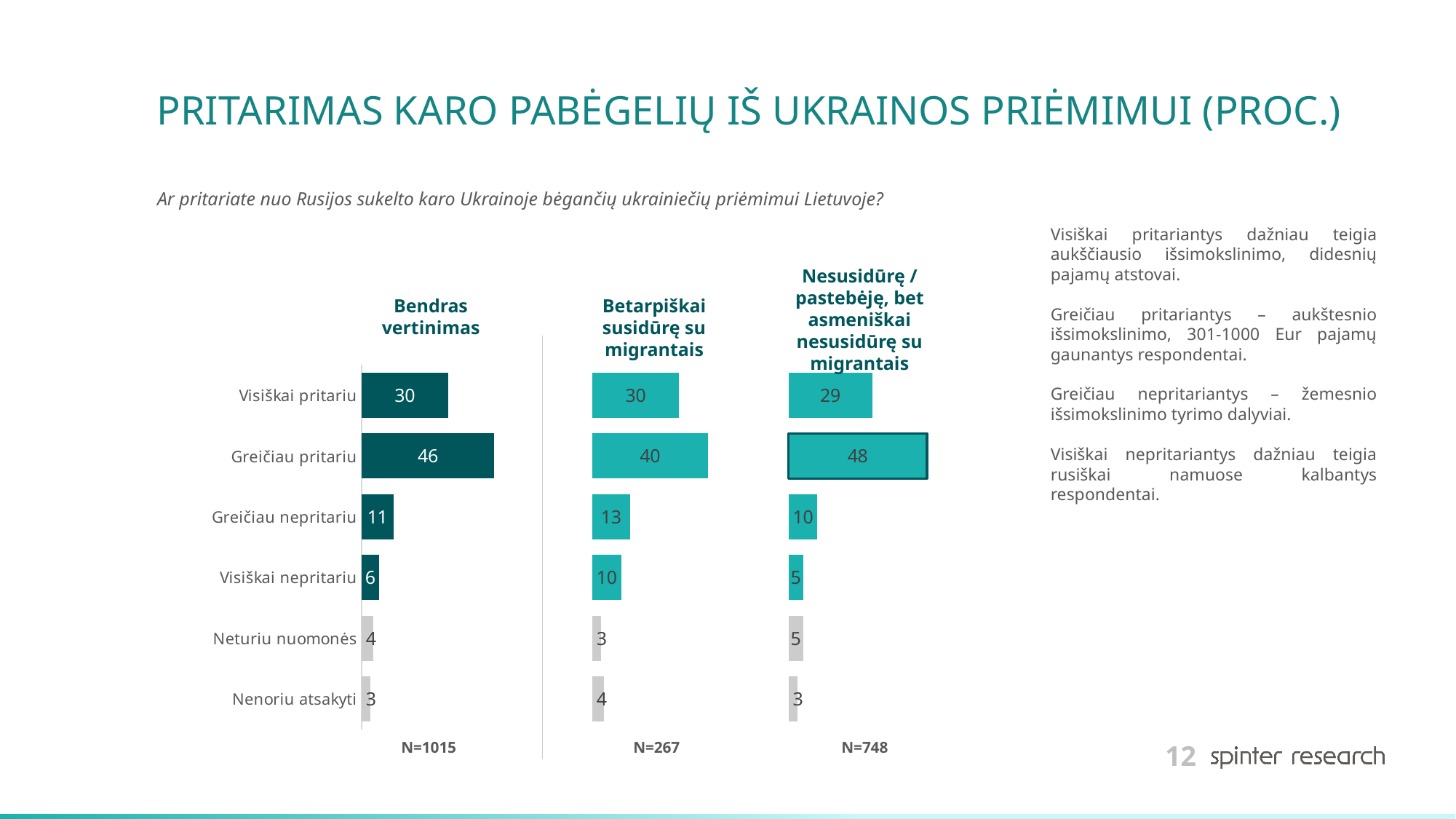
What is the sample size (N) shown under the "Betarpiškai susidūrę su migrantais" chart? N=267 What type of chart is used on this slide? Bar chart How many categories are shown in the "Bendras vertinimas" chart? 6 What is the sample size (N) shown under the "Bendras vertinimas" chart? N=1015 In the "Bendras vertinimas" chart, which category has the lowest value? Nenoriu atsakyti In the "Betarpiškai susidūrę su migrantais" chart, what is the value for "Greičiau nepritariu"? 13 Which is larger: "Greičiau pritariu" in the "Betarpiškai susidūrę su migrantais" chart or "Greičiau pritariu" in the "Nesusidūrę / pastebėję, bet asmeniškai nesusidūrę su migrantais" chart? Nesusidūrę / pastebėję, bet asmeniškai nesusidūrę su migrantais In the "Nesusidūrę / pastebėję, bet asmeniškai nesusidūrę su migrantais" chart, which category has the highest value? Greičiau pritariu In the "Betarpiškai susidūrę su migrantais" chart, what is the difference between "Greičiau pritariu" and "Visiškai pritariu"? 10 In the "Bendras vertinimas" chart, what is the value for "Greičiau pritariu"? 46 In the "Bendras vertinimas" chart, what is the difference between "Greičiau nepritariu" and "Visiškai nepritariu"? 5 In the "Nesusidūrę / pastebėję, bet asmeniškai nesusidūrę su migrantais" chart, what is the value for "Visiškai pritariu"? 29